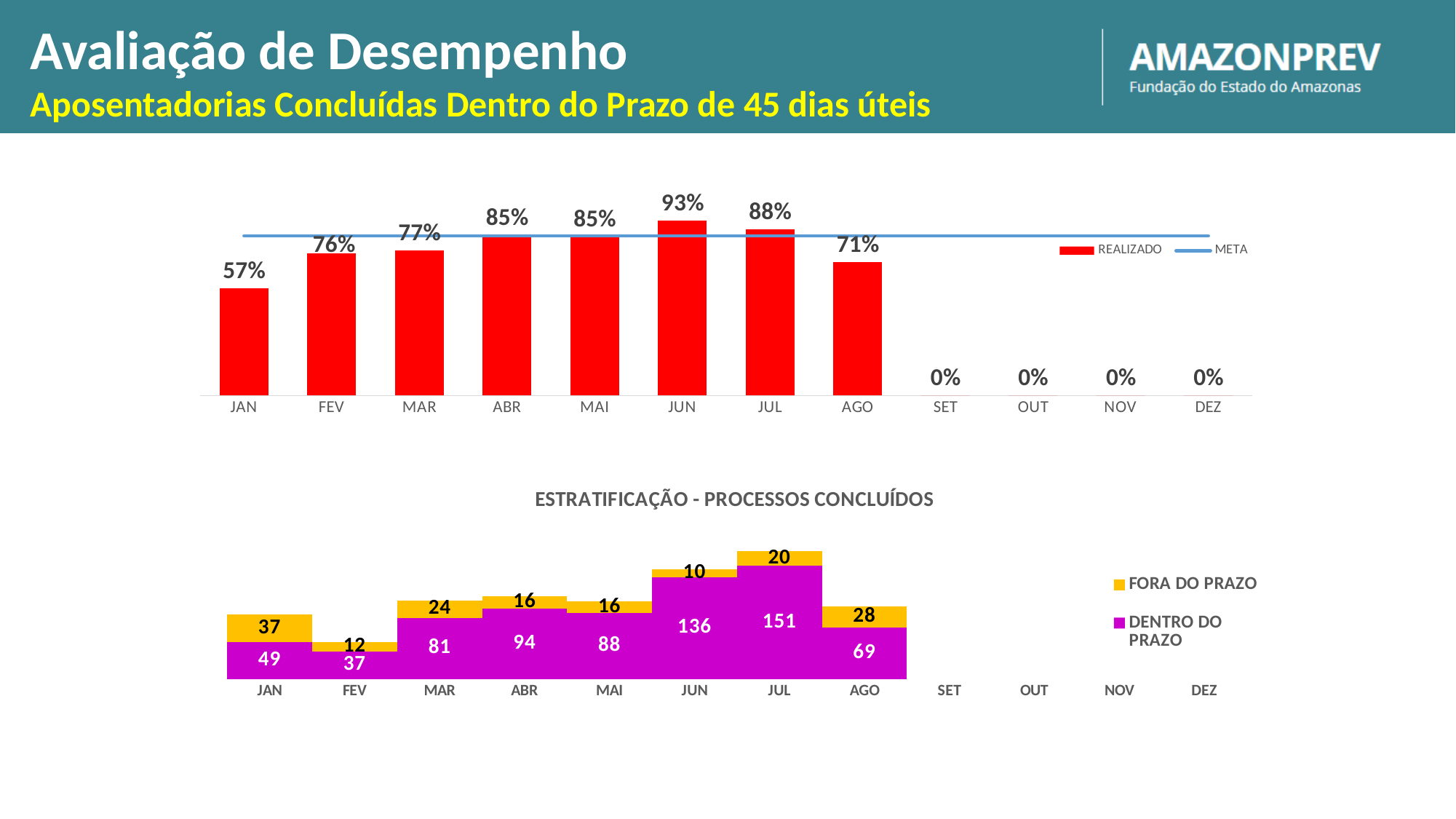
In the top chart, which month from JAN to AGO has the highest REALIZADO value? JUN In the top chart, what is the difference between the REALIZADO values for JUL and AGO? 17% In the ESTRATIFICAÇÃO - PROCESSOS CONCLUÍDOS chart, which month has the lowest FORA DO PRAZO value? JUN In the top chart, which is larger, the REALIZADO value for FEV or for MAR? MAR In the top chart, how many series does the legend list? 2 In the top chart, what is the REALIZADO value for JUN? 93% In the ESTRATIFICAÇÃO - PROCESSOS CONCLUÍDOS chart, what is the DENTRO DO PRAZO value for JUL? 151 In the top chart, what is the REALIZADO value for JAN? 57% In the ESTRATIFICAÇÃO - PROCESSOS CONCLUÍDOS chart, what is the FORA DO PRAZO value for JAN? 37 In the ESTRATIFICAÇÃO - PROCESSOS CONCLUÍDOS chart, what is the total of the stacked bar for JUN? 146 In the ESTRATIFICAÇÃO - PROCESSOS CONCLUÍDOS chart, what is the difference between the DENTRO DO PRAZO values for ABR and MAI? 6 What type of chart is the ESTRATIFICAÇÃO - PROCESSOS CONCLUÍDOS chart? Stacked bar chart